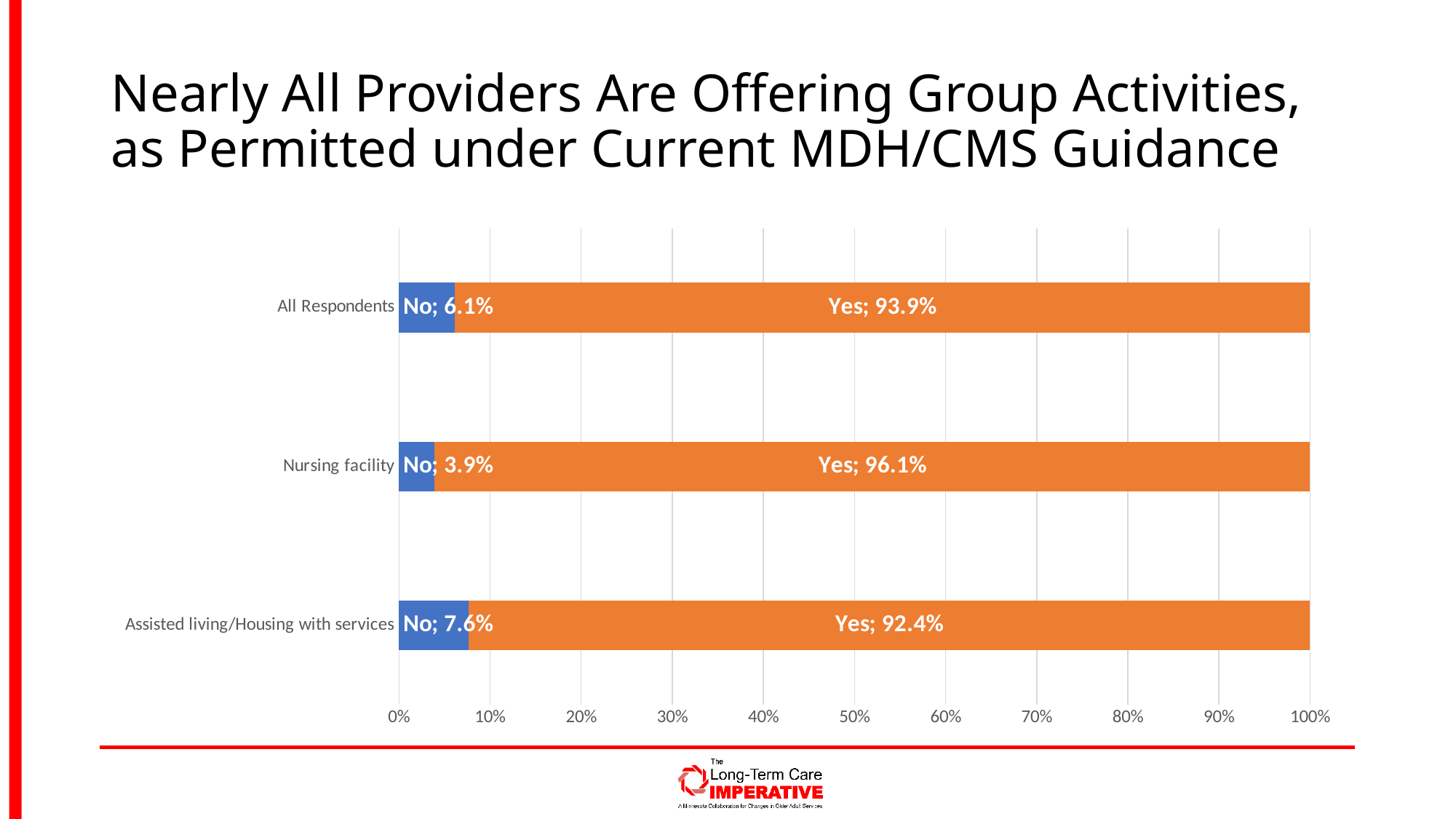
What percentage of All Respondents answered No? 6.1% What kind of chart is shown on the slide? Stacked bar chart What percentage of Assisted living/Housing with services respondents answered Yes? 92.4% What is the difference between the No percentages for Assisted living/Housing with services and Nursing facility? 3.7% What percentage of All Respondents answered Yes? 93.9% What is the total of the Yes and No segments for the Nursing facility bar? 100% What percentage of Nursing facility respondents answered No? 3.9% Which category has the highest Yes percentage? Nursing facility Which category has the lowest No percentage? Nursing facility What colour are the Yes segments of the bars? Orange Which is larger: the Yes percentage for Nursing facility or for Assisted living/Housing with services? Nursing facility How many categories are shown on the chart? 3